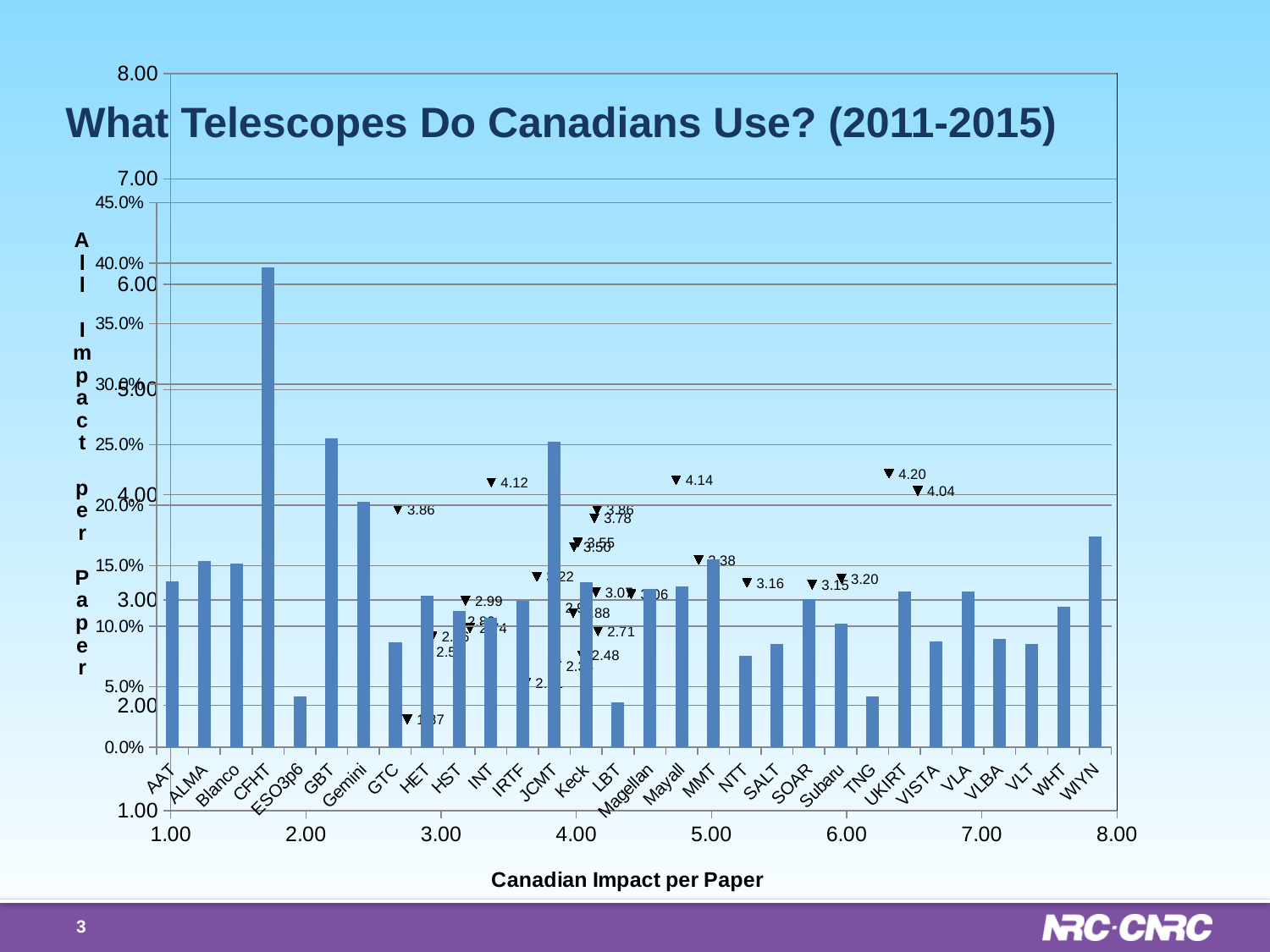
How many telescopes are listed along the x axis of the bar chart? 30 Which bar is taller, CFHT or GBT? CFHT Is the bar for CFHT greater or less than 35.0%? greater Is the bar for VLA greater or less than 10.0%? greater Is the bar for AAT greater or less than 15.0%? less What type of chart is used to show the percentage values for each telescope? bar chart Which bar is taller, Gemini or HET? Gemini What is the title of the slide's chart? What Telescopes Do Canadians Use? (2011-2015) Which telescope has the highest bar in the bar chart? CFHT What is the x-axis label of the overlaid scatter chart with triangle markers? Canadian Impact per Paper